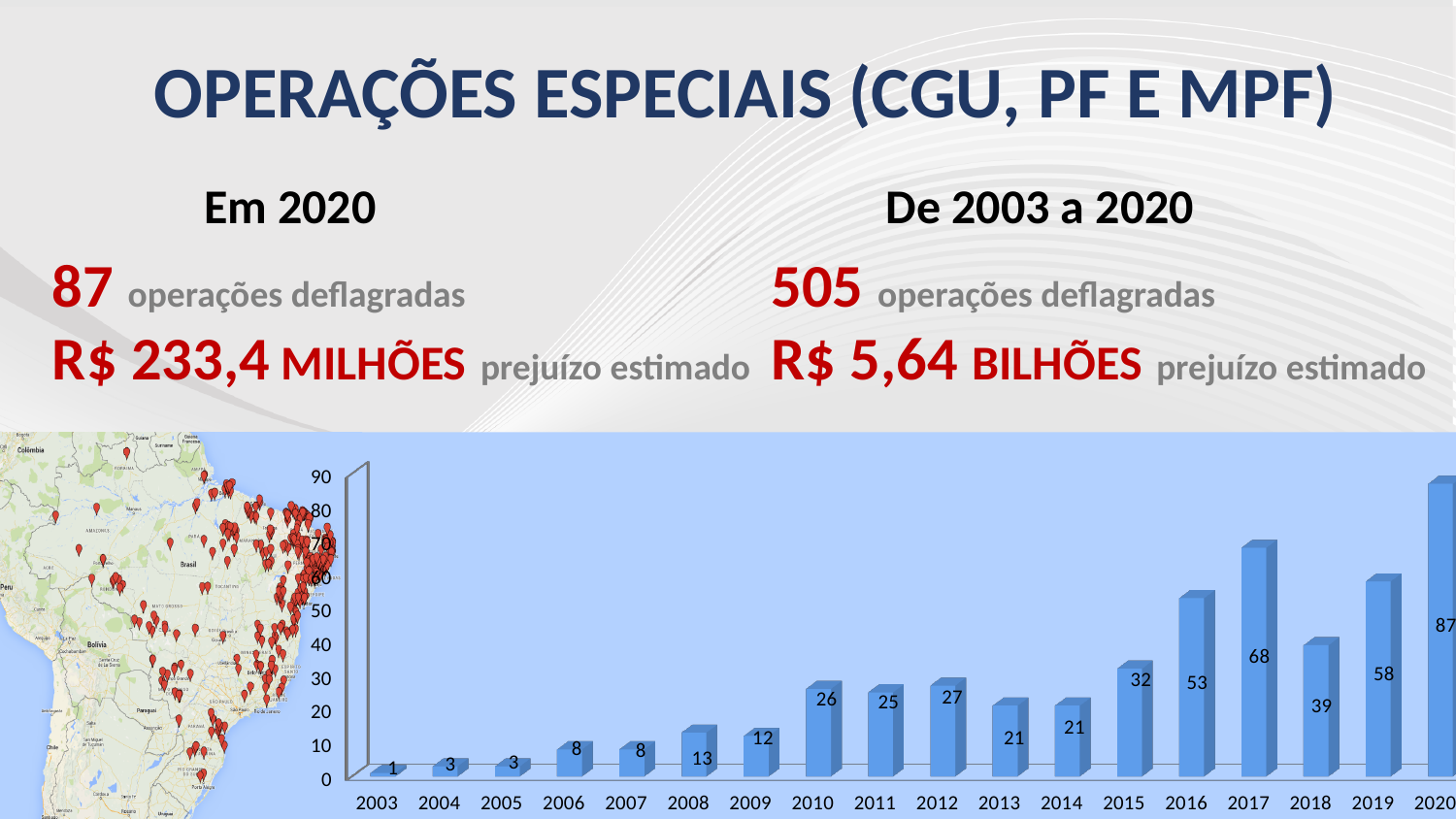
Which is larger in the bar chart, the value for 2016 or the value for 2018? 2016 What is the value for 2008 in the bar chart? 13 Is the value for 2015 in the bar chart greater or less than 30? greater Which year has the lowest value in the bar chart? 2003 What is the difference between the values for 2020 and 2019 in the bar chart? 29 Do the values in the bar chart generally rise or fall from 2003 to 2020? rise What kind of chart is shown at the bottom of the slide? bar chart Which year has the highest value in the bar chart? 2020 What is the difference between the values for 2017 and 2018 in the bar chart? 29 What is the value for 2020 in the bar chart? 87 How many years are shown on the x axis of the bar chart? 18 What is the value for 2017 in the bar chart? 68